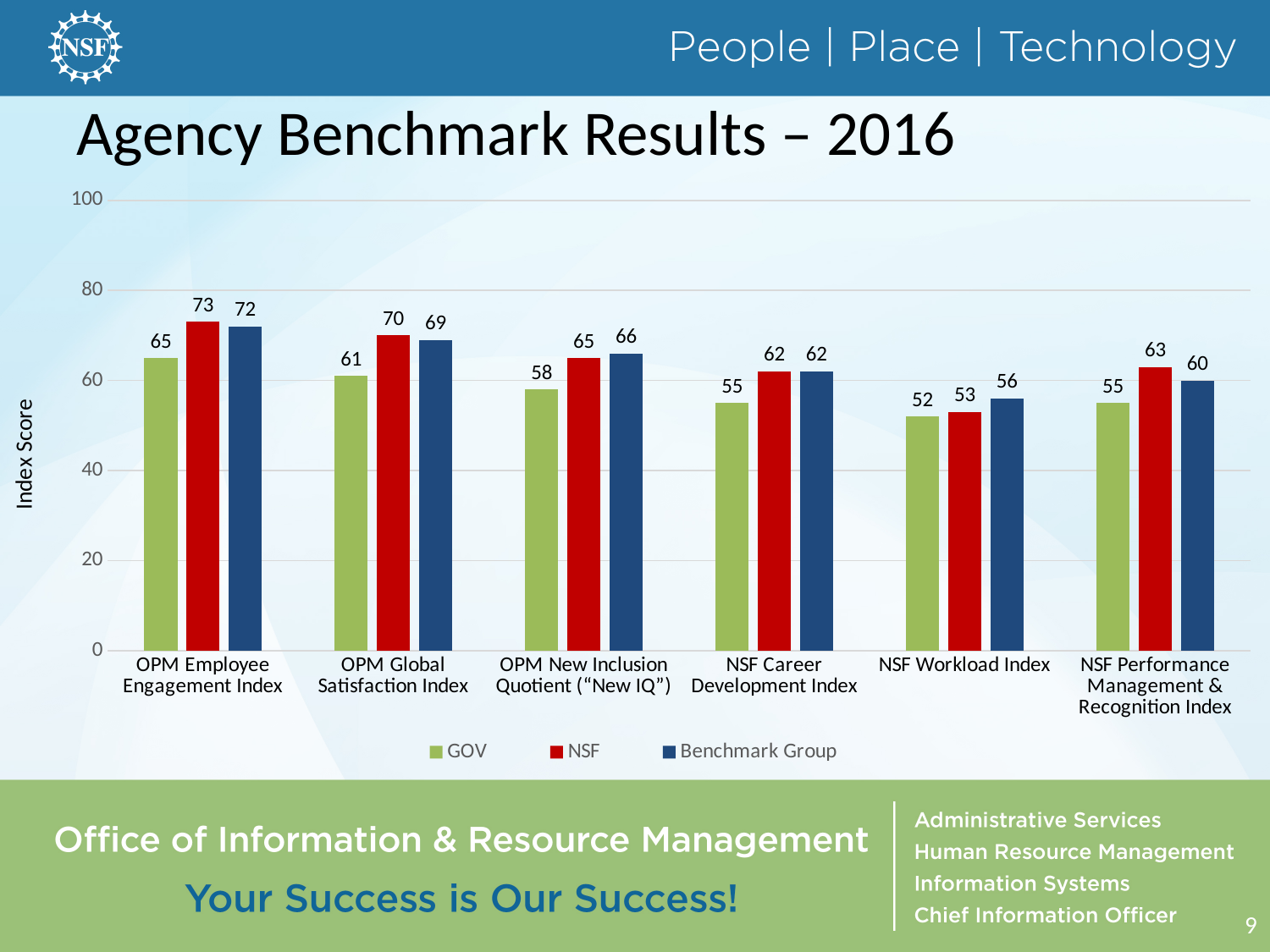
What is the Benchmark Group value for the NSF Workload Index? 56 Is the GOV value for the NSF Career Development Index greater or less than 60? less Which category has the lowest GOV value? NSF Workload Index Which category has the highest NSF value? OPM Employee Engagement Index What is the GOV value for the OPM Global Satisfaction Index? 61 What is the difference between the NSF and GOV values for the OPM Global Satisfaction Index? 9 How many series does the legend list? 3 What is the label of the y axis? Index Score What is the NSF value for the OPM Employee Engagement Index? 73 For the OPM New Inclusion Quotient ("New IQ"), which is larger: the NSF value or the Benchmark Group value? Benchmark Group How many categories are shown on the x axis? 6 What kind of chart is shown on the slide? bar chart